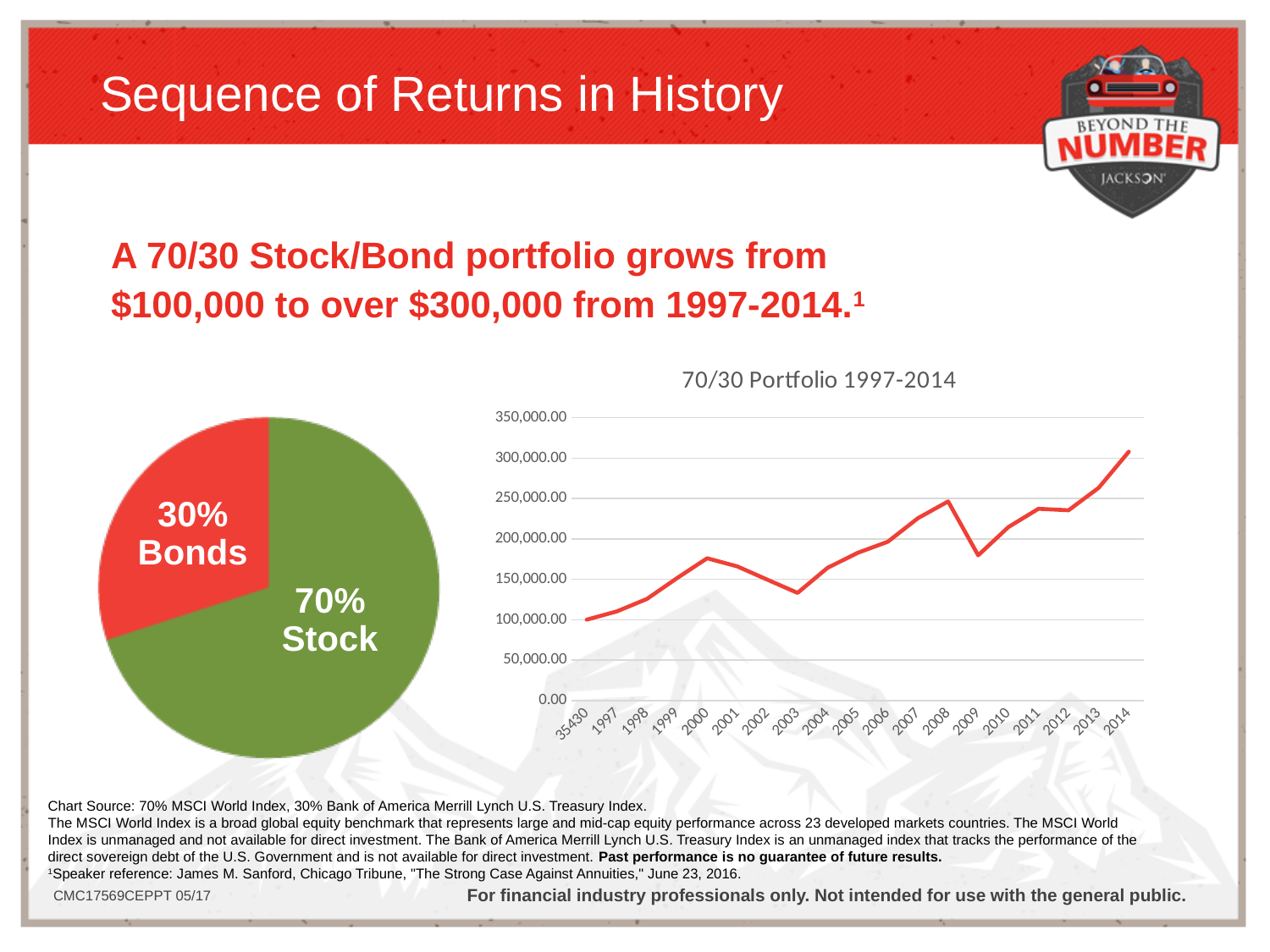
What kind of chart is the chart on the left of the slide? pie chart In the pie chart, what share of the portfolio is Stock? 70% What kind of chart is the chart titled '70/30 Portfolio 1997-2014'? line chart How many slices does the pie chart have? 2 What is the title of the line chart? 70/30 Portfolio 1997-2014 In the '70/30 Portfolio 1997-2014' chart, is the value for 2014 greater or less than 250,000.00? greater In the '70/30 Portfolio 1997-2014' chart, is the value for 2009 greater or less than 200,000.00? less In the '70/30 Portfolio 1997-2014' chart, which year has the highest value? 2014 In the '70/30 Portfolio 1997-2014' chart, which year has the larger value, 2008 or 2009? 2008 In the pie chart, what colour is the Bonds slice? red In the pie chart, what share of the portfolio is Bonds? 30% In the pie chart, which slice is larger, Stock or Bonds? Stock